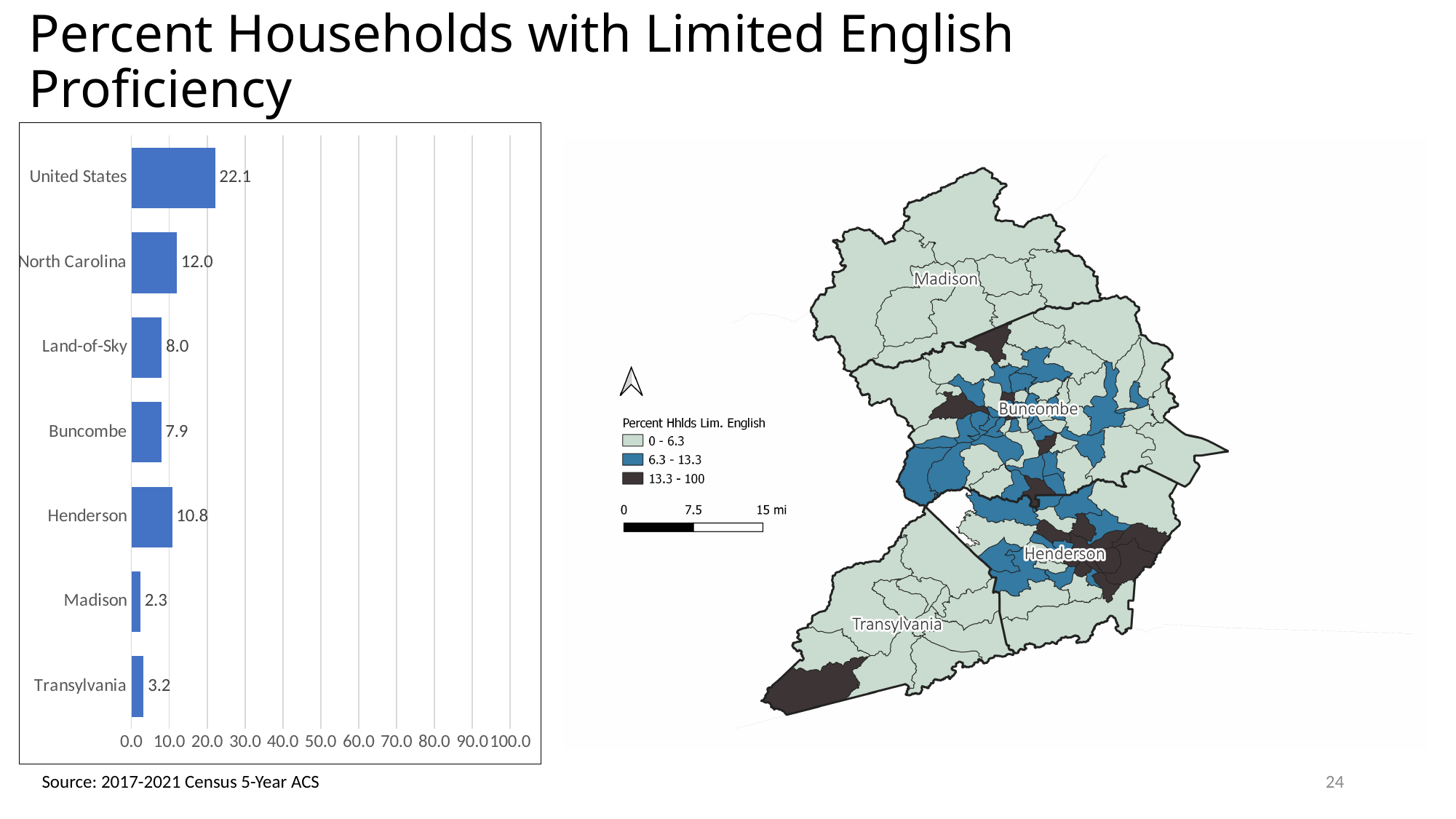
What is the highest value shown on the x axis of the bar chart? 100.0 Which has a larger value in the bar chart, Henderson or Buncombe? Henderson What is the difference between the values for Transylvania and Madison in the bar chart? 0.9 What is the value for Henderson in the bar chart? 10.8 Which category has the lowest value in the bar chart? Madison What kind of chart is shown on the left of the slide? bar chart Which category has the highest value in the bar chart? United States What is the value for Madison in the bar chart? 2.3 How many categories are shown in the bar chart? 7 What is the value for the United States in the bar chart? 22.1 What is the difference between the values for North Carolina and Land-of-Sky in the bar chart? 4.0 Is the value for the United States in the bar chart greater or less than 20.0? greater